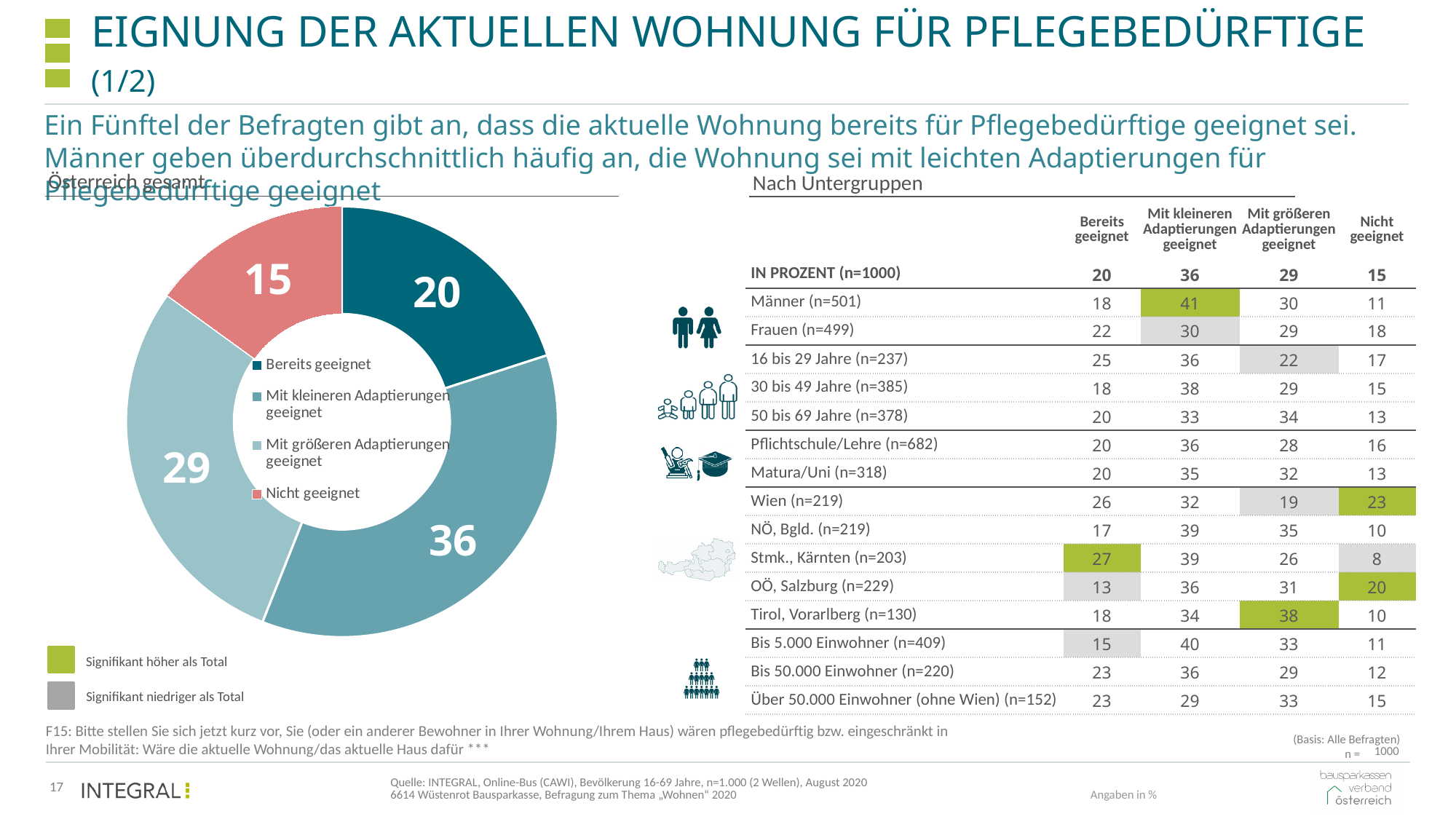
In the "Österreich gesamt" chart, what is the value for "Mit größeren Adaptierungen geeignet"? 29 In the "Österreich gesamt" chart, what is the combined value of "Bereits geeignet" and "Mit kleineren Adaptierungen geeignet"? 56 In the "Österreich gesamt" chart, what is the difference between "Mit kleineren Adaptierungen geeignet" and "Nicht geeignet"? 21 In the "Österreich gesamt" chart, what is the value for "Bereits geeignet"? 20 In the "Österreich gesamt" chart, what is the value for "Mit kleineren Adaptierungen geeignet"? 36 In the "Österreich gesamt" chart, what is the value for "Nicht geeignet"? 15 How many categories does the "Österreich gesamt" donut chart show? 4 What kind of chart is shown under "Österreich gesamt"? Donut (pie) chart In the "Österreich gesamt" chart, what colour is the "Nicht geeignet" segment? Red/pink In the "Österreich gesamt" chart, which category has the smallest share? Nicht geeignet In the "Österreich gesamt" chart, which category has the largest share? Mit kleineren Adaptierungen geeignet In the "Österreich gesamt" chart, which is larger: "Bereits geeignet" or "Mit größeren Adaptierungen geeignet"? Mit größeren Adaptierungen geeignet